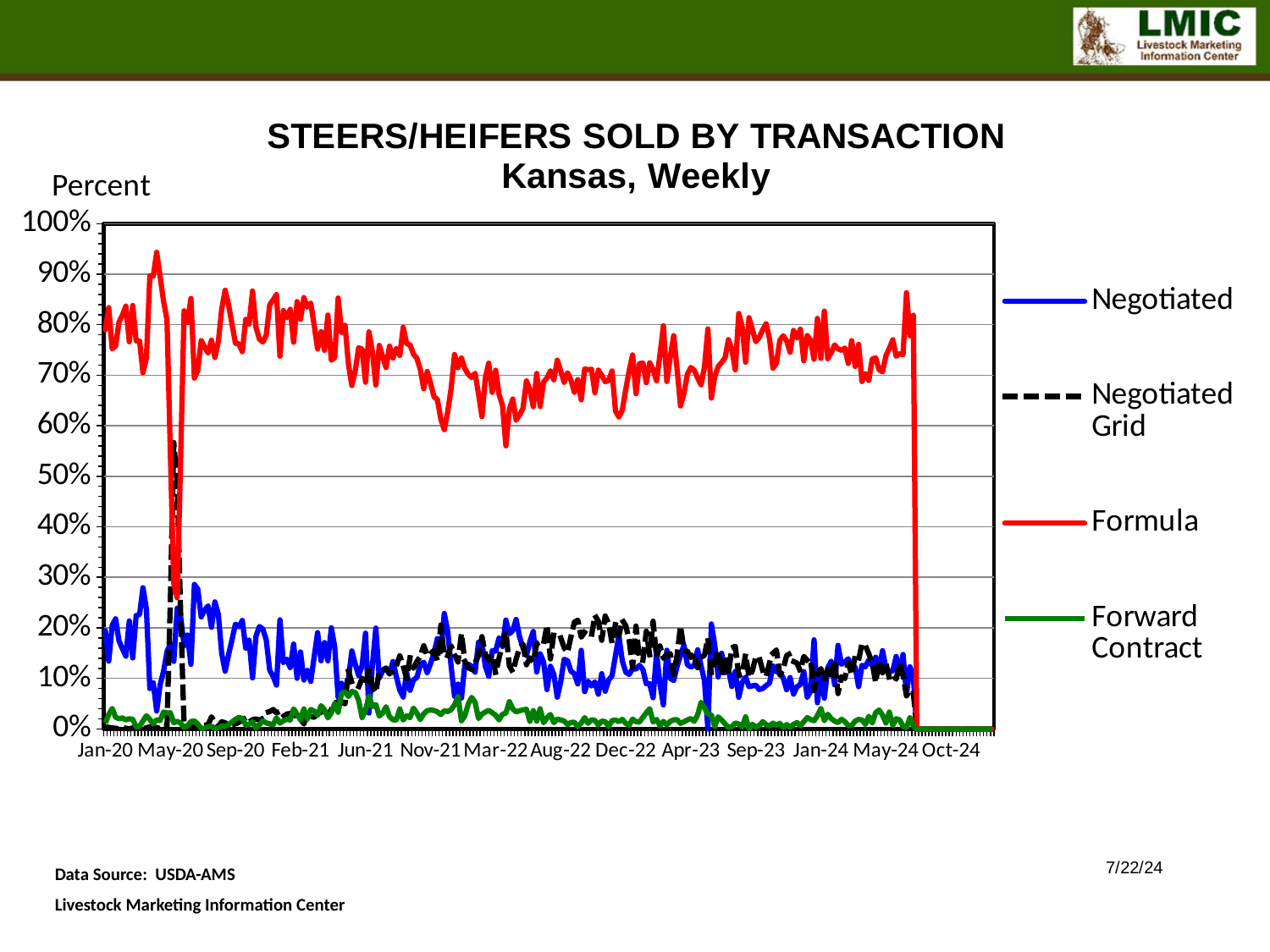
Does the Negotiated Grid series generally rise or fall from Jan-20 to Aug-22? rise How many series does the legend list? 4 Is the value for Forward Contract in Jan-24 greater or less than 10%? less Is the value for Formula in Jan-20 greater or less than 70%? greater Which series has the lowest values across most of the chart? Forward Contract Which is larger in Jan-20, Negotiated or Negotiated Grid? Negotiated Which series has the highest values across the chart? Formula What kind of chart is shown on the slide? line chart Is the value for Negotiated in Jan-20 greater or less than 10%? greater What is the label on the vertical axis of the chart? Percent